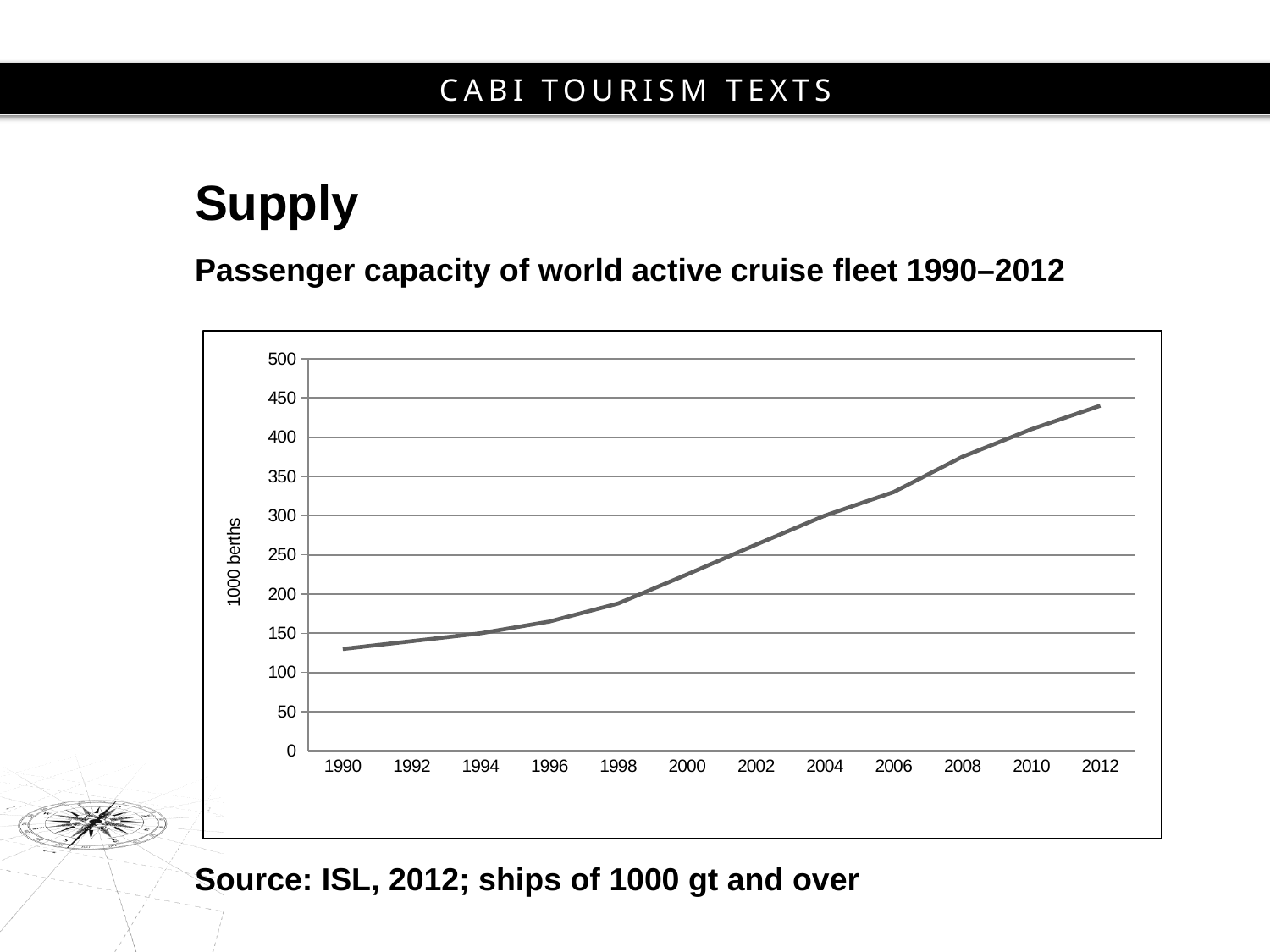
Is the value for 1998 greater or less than 200? less Which year has the lowest passenger capacity? 1990 Is the value for 2008 greater or less than 350? greater Do the values rise or fall from 1990 to 2012? rise Is the value for 2012 greater or less than 400? greater How many years are labelled on the x axis? 12 What is the label on the y axis? 1000 berths What kind of chart is shown on the slide? line chart Which year has the highest passenger capacity? 2012